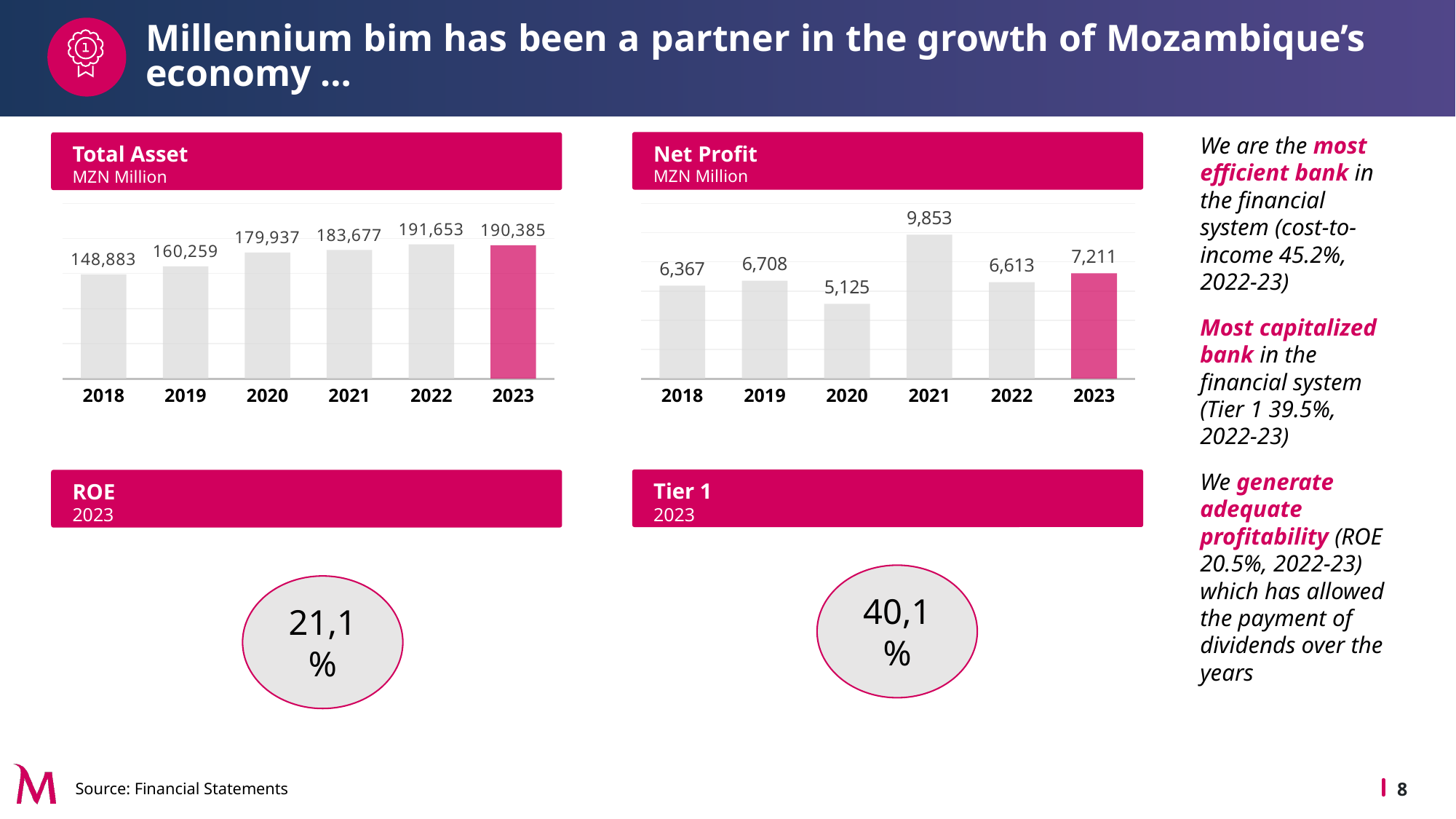
In the Net Profit chart, what is the value for 2023? 7,211 In the Net Profit chart, which is larger, the value for 2019 or the value for 2022? 2019 How many years are shown in the Net Profit chart? 6 In the Net Profit chart, what is the value for 2021? 9,853 In the Net Profit chart, which year has the lowest value? 2020 In the Net Profit chart, what is the difference between the 2021 and 2020 values? 4,728 In the Total Asset chart, what is the value for 2023? 190,385 In the Total Asset chart, what is the difference between the 2022 and 2023 values? 1,268 In the Total Asset chart, which year has the lowest value? 2018 What kind of chart is the Total Asset chart? Bar chart In the Total Asset chart, what is the value for 2018? 148,883 In the Total Asset chart, which year has the highest value? 2022